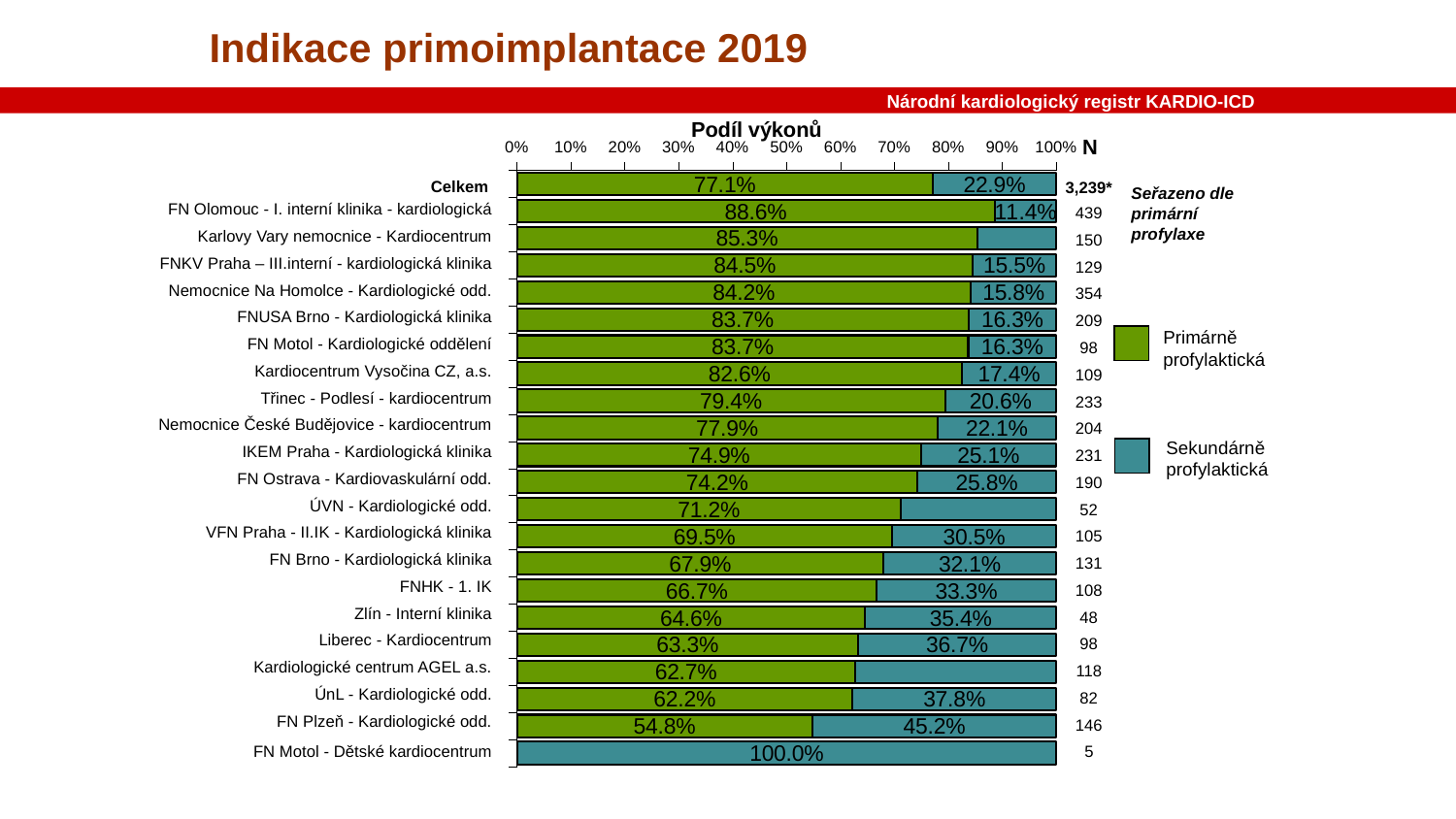
What is the Primárně profylaktická share for Celkem? 77.1% What is the N value shown for IKEM Praha - Kardiologická klinika? 231 What kind of chart is shown on the slide? Stacked horizontal bar chart Which centre has the highest Primárně profylaktická share? FN Olomouc - I. interní klinika - kardiologická How many series does the legend list? 2 How many categories (rows) are shown in the chart? 22 What is the difference between the Primárně profylaktická and Sekundárně profylaktická shares for Celkem? 54.2 percentage points What is the Primárně profylaktická share for Zlín - Interní klinika? 64.6% What are the two legend entries of the chart? Primárně profylaktická and Sekundárně profylaktická What is the Sekundárně profylaktická share for FN Plzeň - Kardiologické odd.? 45.2% Is the Sekundárně profylaktická value for Karlovy Vary nemocnice - Kardiocentrum greater or less than 20%? less Which has a larger Primárně profylaktická share, FN Brno - Kardiologická klinika or FNHK - 1. IK? FN Brno - Kardiologická klinika